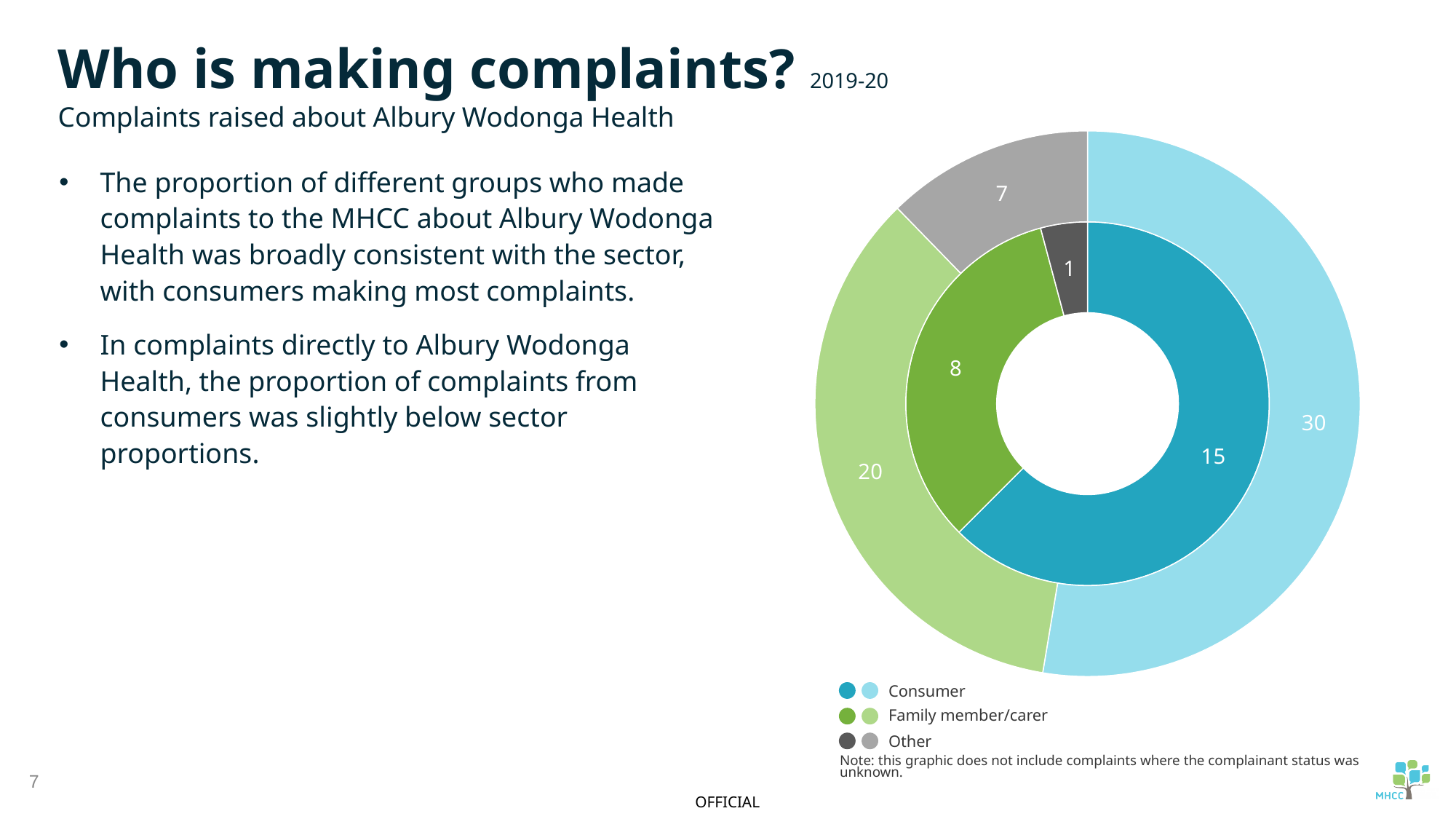
How many groups does the legend of the doughnut chart list? 3 What kind of chart is shown on the slide? Doughnut chart In the inner ring, is the value for Consumer or Family member/carer larger? Consumer Which group has the largest value in the outer ring of the doughnut chart? Consumer Which group has the smallest value in the inner ring of the doughnut chart? Other Which group is shown in green in the doughnut chart? Family member/carer What is the total of all values in the inner ring of the doughnut chart? 24 What is the value for Other in the outer ring of the doughnut chart? 7 What is the value for Family member/carer in the inner ring of the doughnut chart? 8 What is the difference between the Consumer and Family member/carer values in the outer ring? 10 What is the value for Consumer in the outer ring of the doughnut chart? 30 What is the value for Other in the inner ring of the doughnut chart? 1